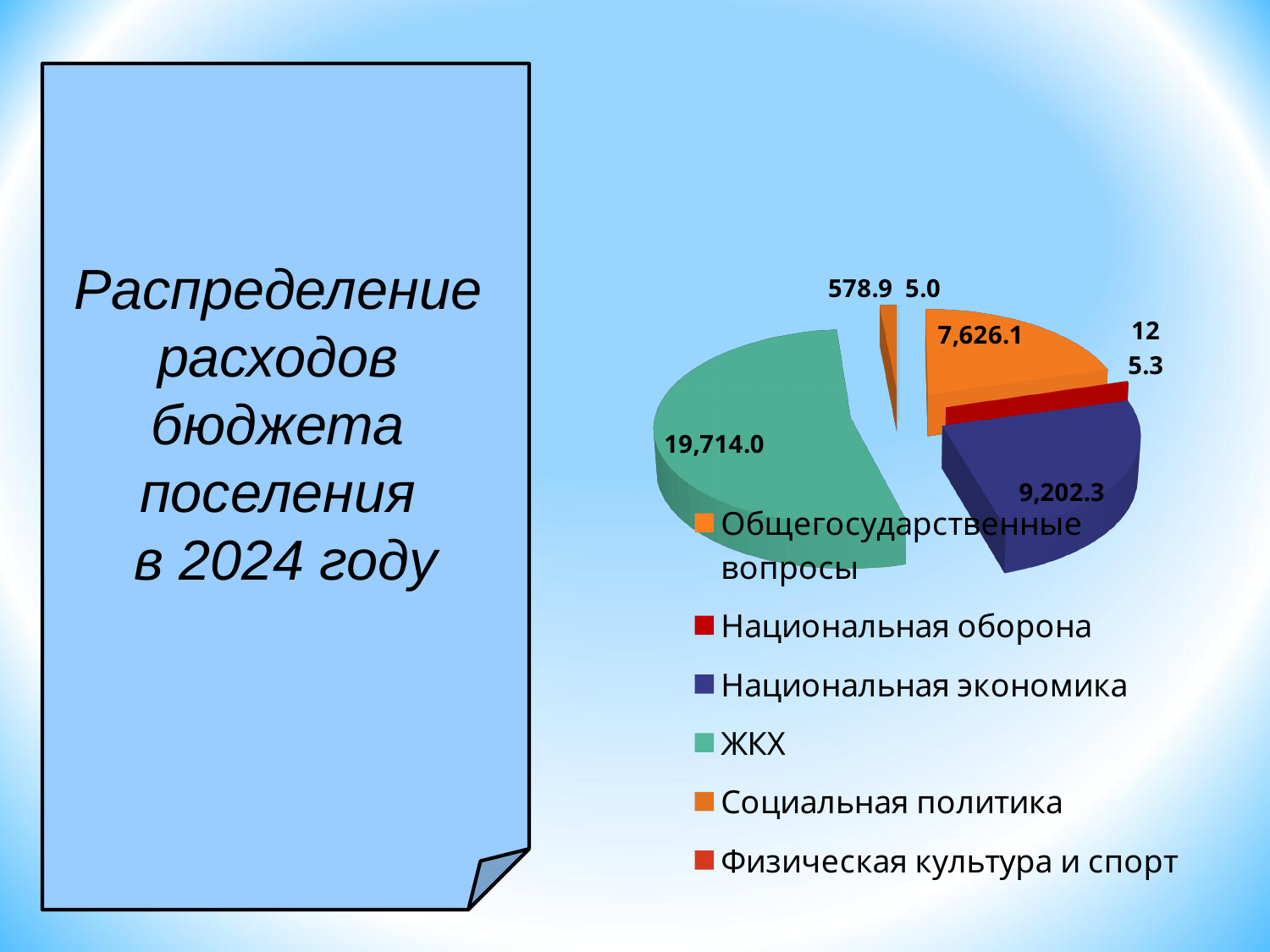
What is the value for Социальная политика in the pie chart? 578.9 What kind of chart is shown on the slide? Pie chart What is the value for Общегосударственные вопросы in the pie chart? 7,626.1 What is the difference between the values for Национальная экономика and Общегосударственные вопросы? 1,576.2 Which is larger, Национальная экономика or Общегосударственные вопросы? Национальная экономика Which category has the largest slice of the pie chart? ЖКХ What is the value for ЖКХ in the pie chart? 19,714.0 How many categories does the legend of the pie chart list? 6 What is the difference between the values for ЖКХ and Национальная экономика? 10,511.7 What is the value for Национальная экономика in the pie chart? 9,202.3 What colour is the ЖКХ slice in the pie chart? Green (teal) Which is larger, ЖКХ or Национальная экономика? ЖКХ